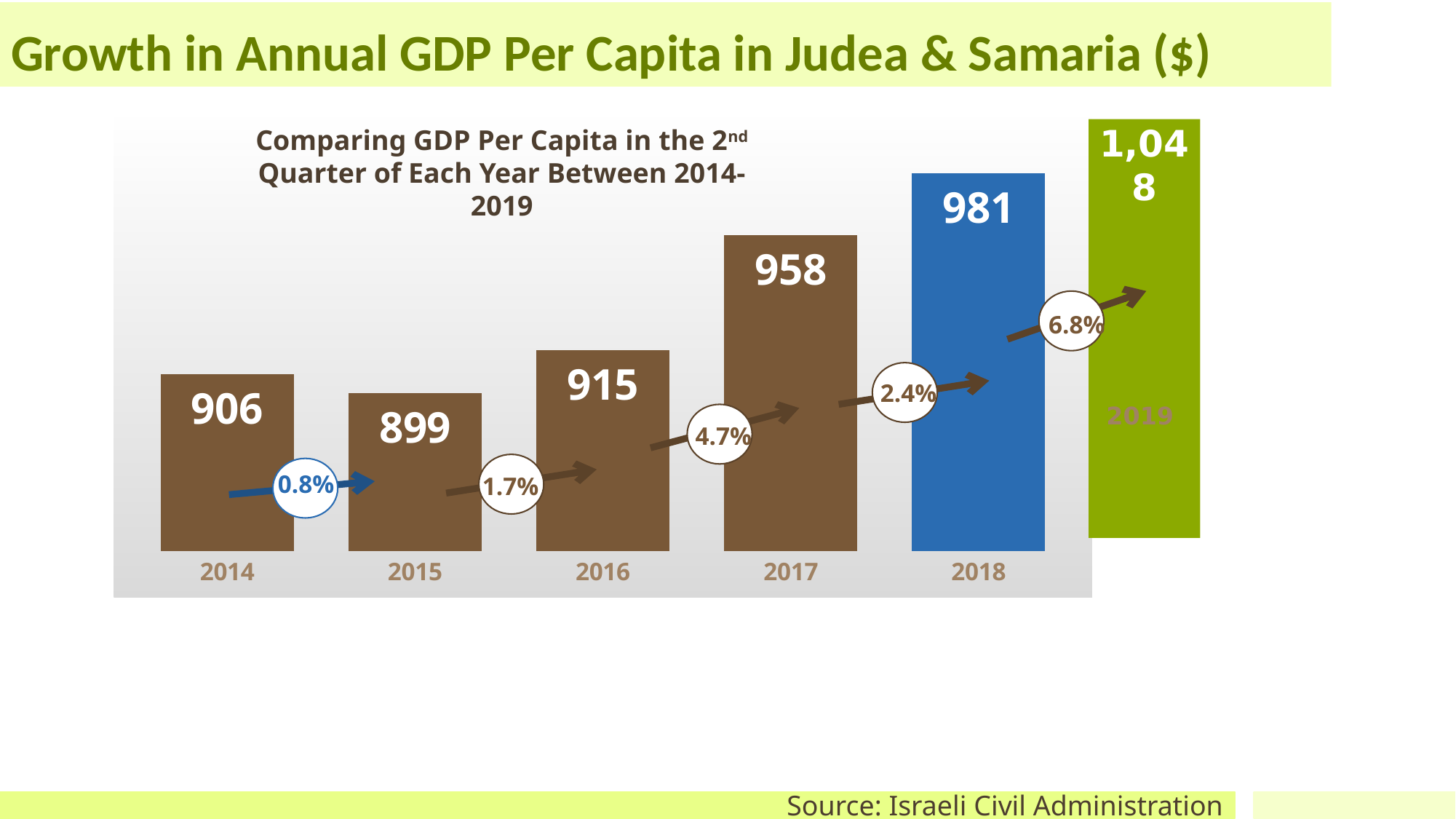
How many years are shown in the chart? 6 Do the values generally rise or fall from 2015 to 2019? rise What is the GDP per capita value shown for 2018? 981 What is the GDP per capita value shown for 2019? 1,048 What is the GDP per capita value shown for 2017? 958 What is the difference between the 2018 and 2017 values? 23 What percentage growth is shown between 2018 and 2019? 6.8% What is the GDP per capita value shown for 2014? 906 Which is larger, the value for 2014 or the value for 2015? 2014 What kind of chart is this? bar chart Which year has the lowest GDP per capita value? 2015 Which year has the highest GDP per capita value? 2019